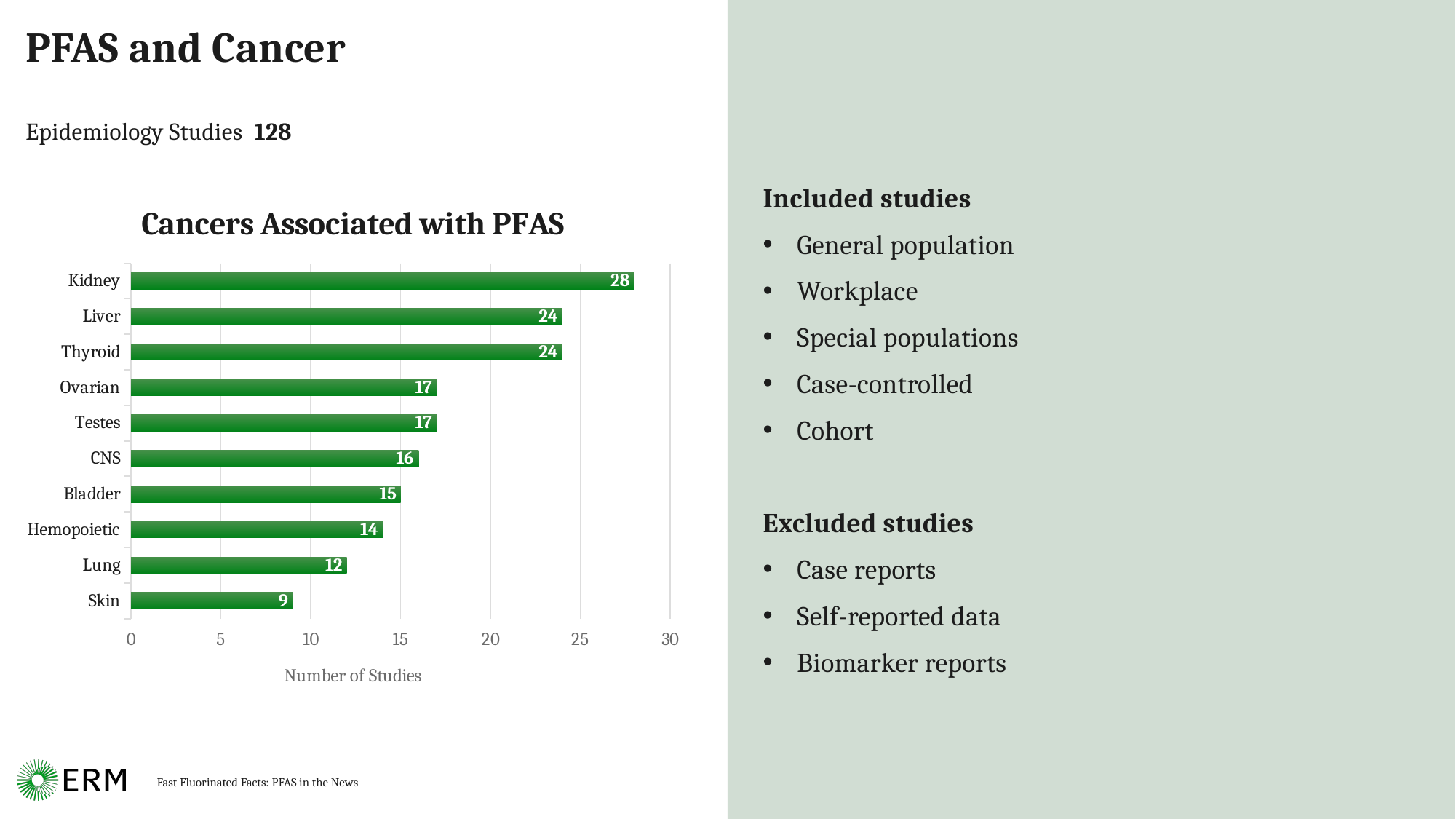
What is the title of the chart? Cancers Associated with PFAS Which cancer has the lowest number of studies? Skin How many cancer categories are shown in the chart? 10 What is the number of studies for Kidney cancer? 28 What kind of chart is shown on the slide? Bar chart Which has more studies, CNS or Lung? CNS Which cancer has the highest number of studies? Kidney Is the value for Thyroid greater or less than 20? greater What is the number of studies for Bladder cancer? 15 What is the difference in number of studies between Lung and Skin? 3 What is the difference in number of studies between Kidney and Liver? 4 What is the number of studies for Hemopoietic cancer? 14